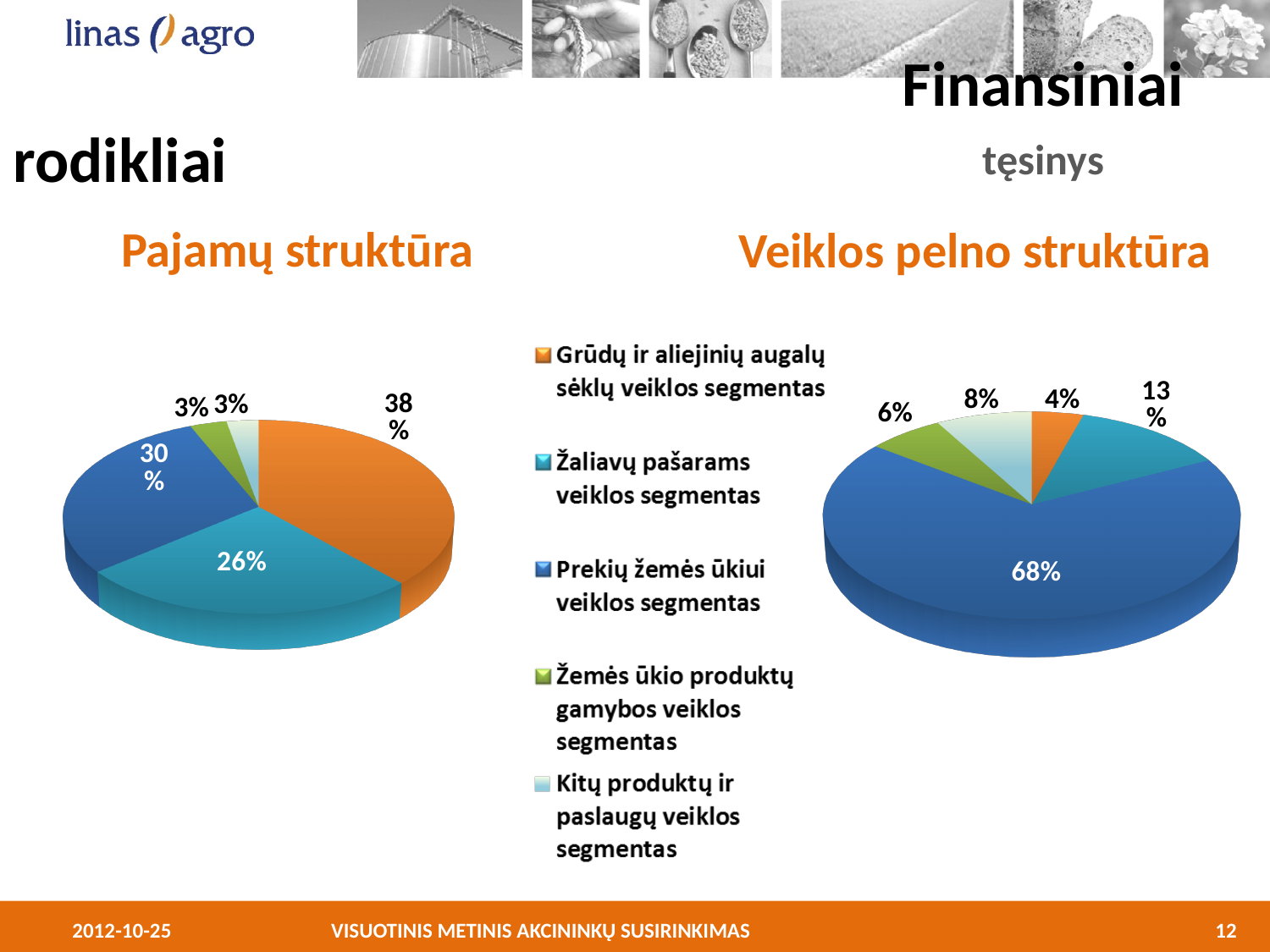
How many segments does the shared legend list for the pie charts? 5 In the 'Pajamų struktūra' pie chart, what share does the Žaliavų pašarams veiklos segmentas (teal) slice have? 26% In the 'Pajamų struktūra' pie chart, what share does the Grūdų ir aliejinių augalų sėklų veiklos segmentas (orange) slice have? 38% What type of chart is used for 'Veiklos pelno struktūra'? Pie chart In the 'Veiklos pelno struktūra' pie chart, what share does the Grūdų ir aliejinių augalų sėklų veiklos segmentas (orange) slice have? 4% In the 'Veiklos pelno struktūra' pie chart, which segment has the smallest share? Grūdų ir aliejinių augalų sėklų veiklos segmentas In the 'Pajamų struktūra' pie chart, which segment has the largest share? Grūdų ir aliejinių augalų sėklų veiklos segmentas In the 'Pajamų struktūra' pie chart, what is the difference between the Grūdų ir aliejinių augalų sėklų segment share and the Žaliavų pašarams segment share? 12% In the 'Veiklos pelno struktūra' pie chart, which segment has the largest share? Prekių žemės ūkiui veiklos segmentas